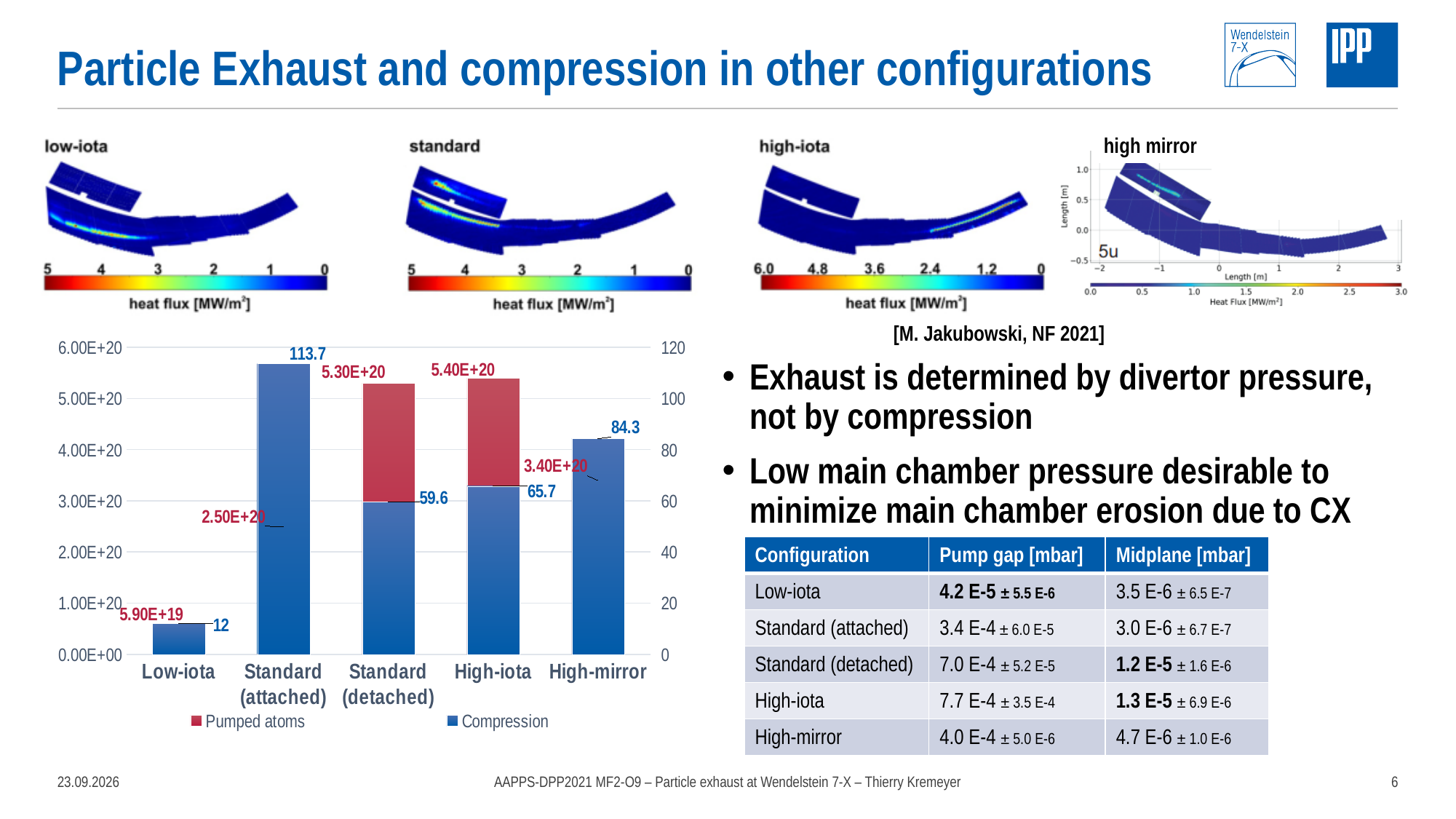
What is the Compression value for Standard (attached)? 113.7 How many series does the legend of the bar chart list? 2 What is the Pumped atoms value for High-iota? 5.40E+20 Which has a higher Compression value, High-iota or High-mirror? High-mirror Which configuration has the lowest Pumped atoms value? Low-iota Which configuration has the highest Compression value? Standard (attached) How many configurations are shown on the x axis of the bar chart? 5 What type of chart is used to show Pumped atoms and Compression? Bar chart What is the Pumped atoms value for Low-iota? 5.90E+19 Which colour represents the Pumped atoms series in the bar chart? Red What is the difference in Compression between Standard (attached) and Standard (detached)? 54.1 What is the Compression value for High-mirror? 84.3